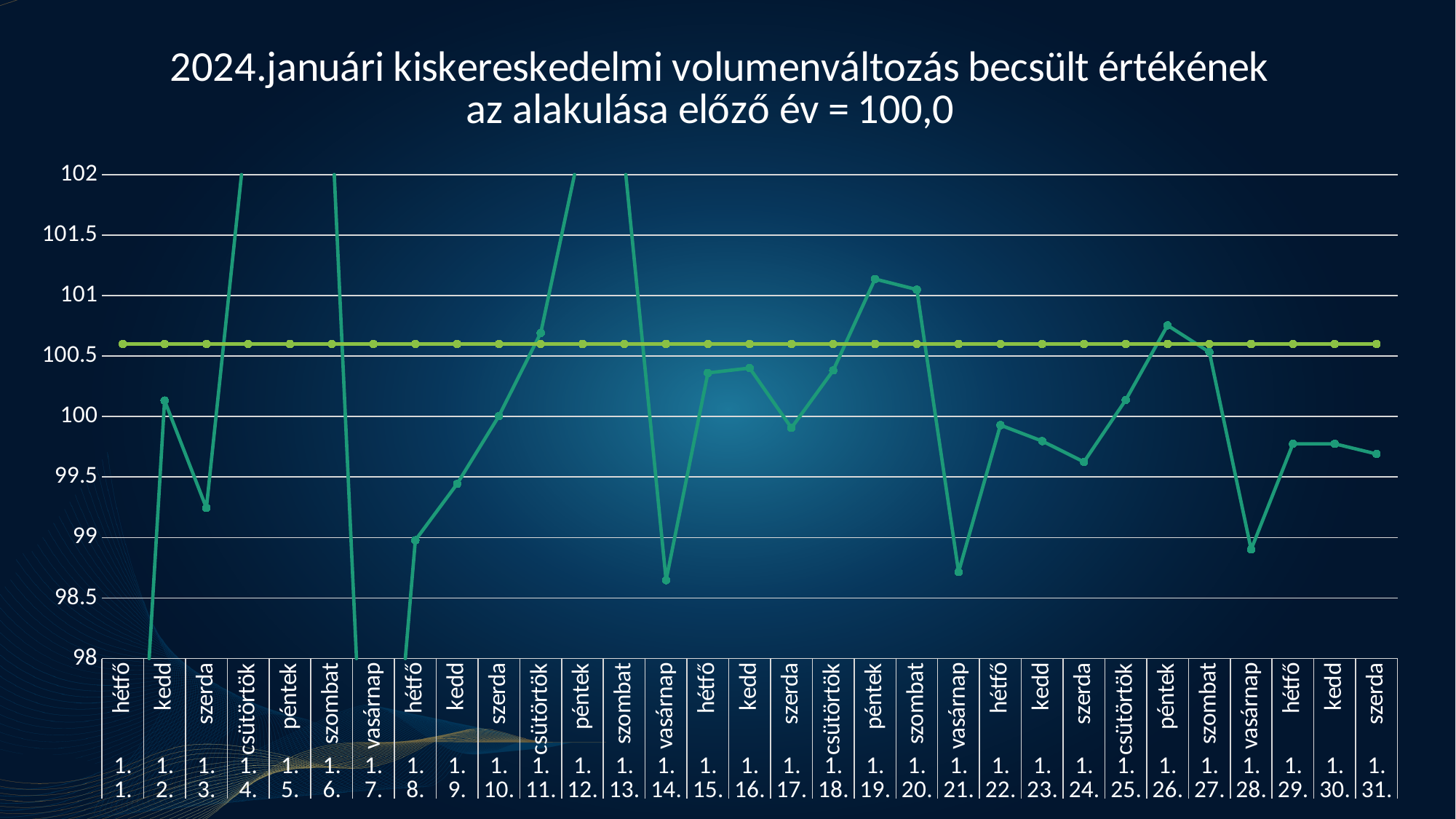
How many days (data points) are plotted along the x axis? 31 Is the value of the fluctuating line for 1. 14. (vasárnap) greater or less than 99? less Is the value of the fluctuating line for 1. 21. (vasárnap) greater or less than 99? less Between which two y-axis gridlines does the flat (constant) line lie? 100.5 and 101 What kind of chart is shown on the slide? line chart What is the title of the chart? 2024.januári kiskereskedelmi volumenváltozás becsült értékének az alakulása előző év = 100,0 Is the value of the fluctuating line for 1. 3. (szerda) greater or less than 100? less Which has the higher value on the fluctuating line: 1. 19. (péntek) or 1. 14. (vasárnap)? 1. 19. (péntek) Which has the higher value on the fluctuating line: 1. 2. (kedd) or 1. 3. (szerda)? 1. 2. (kedd)